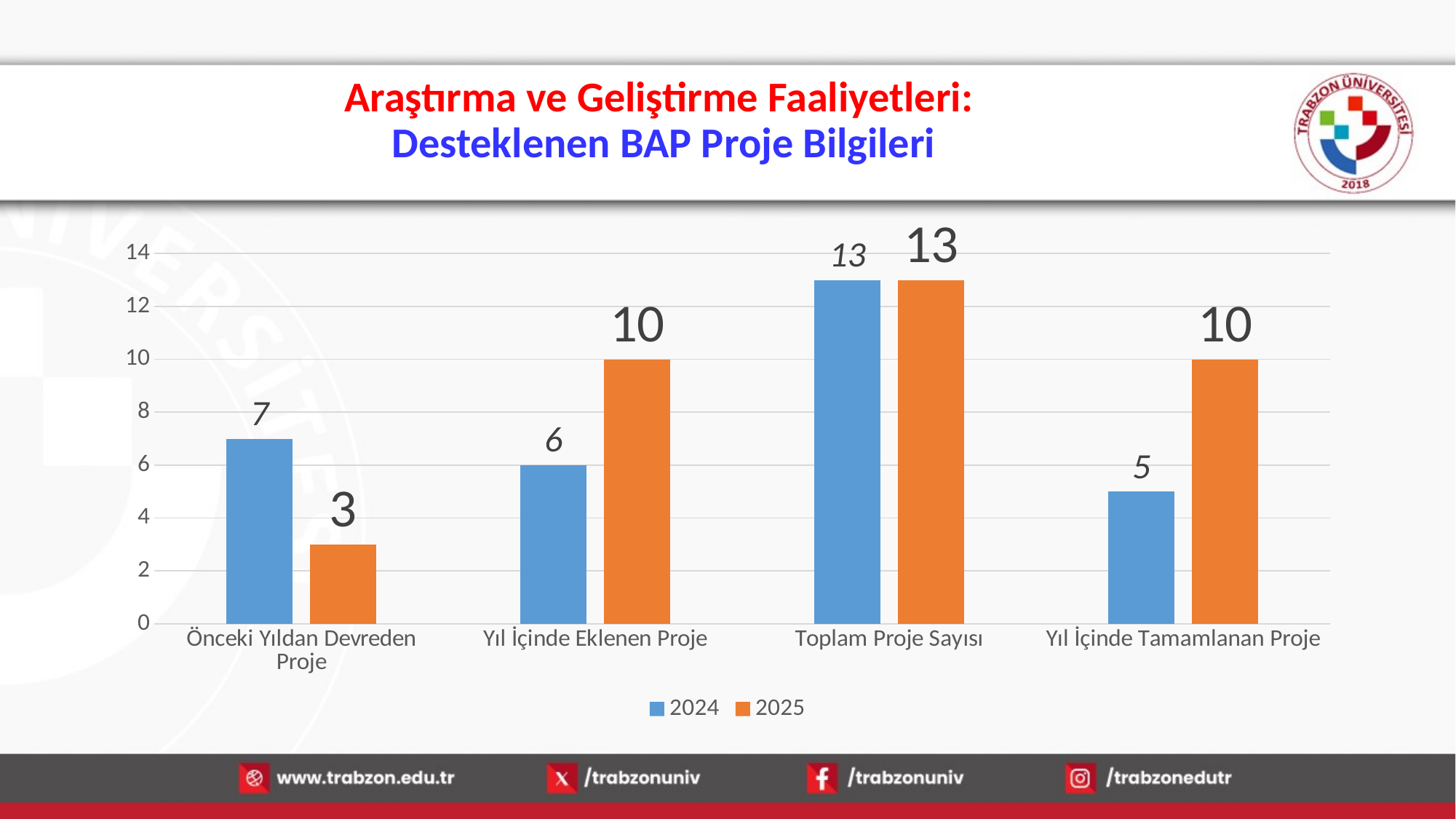
Which category has the highest 2024 value? Toplam Proje Sayısı Which category has the lowest 2025 value? Önceki Yıldan Devreden Proje Which colour represents the 2025 series? Orange What is the 2025 value for Toplam Proje Sayısı? 13 What is the 2024 value for Önceki Yıldan Devreden Proje? 7 What is the 2024 value for Yıl İçinde Tamamlanan Proje? 5 How many series does the legend list? 2 How many categories are shown on the x axis? 4 What is the 2025 value for Yıl İçinde Eklenen Proje? 10 What kind of chart is shown on the slide? Bar chart Which is larger for Önceki Yıldan Devreden Proje, the 2024 value or the 2025 value? 2024 What is the difference between the 2025 and 2024 values for Yıl İçinde Tamamlanan Proje? 5